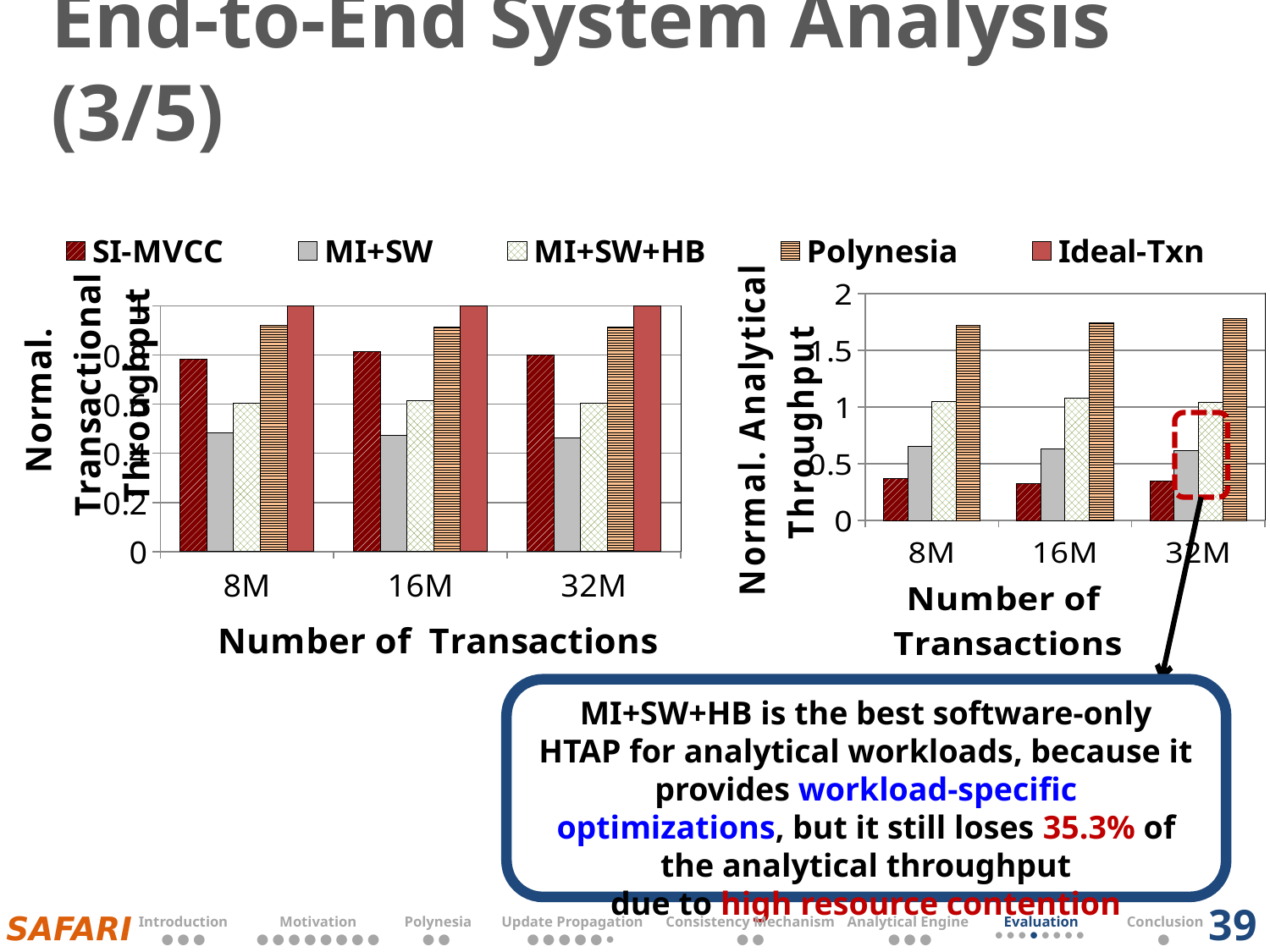
In the right chart (Normal. Analytical Throughput), is the value for Polynesia at 32M greater or less than 1.5? greater What is the x-axis title of the left chart? Number of Transactions In the right chart (Normal. Analytical Throughput), is the value for SI-MVCC at 8M greater or less than 0.5? less In the left chart (Normal. Transactional Throughput), which is larger at 8M: Polynesia or MI+SW+HB? Polynesia How many categories are shown on the x axis of the right chart (Normal. Analytical Throughput)? 3 What kind of chart is the left chart (Normal. Transactional Throughput)? bar chart In the right chart (Normal. Analytical Throughput), which series has the highest value at 8M? Polynesia In the left chart (Normal. Transactional Throughput), which series has the lowest value at 32M? MI+SW In the right chart (Normal. Analytical Throughput), which series has the lowest value at 16M? SI-MVCC In the right chart (Normal. Analytical Throughput), which is larger at 8M: MI+SW or SI-MVCC? MI+SW How many series does the legend list? 5